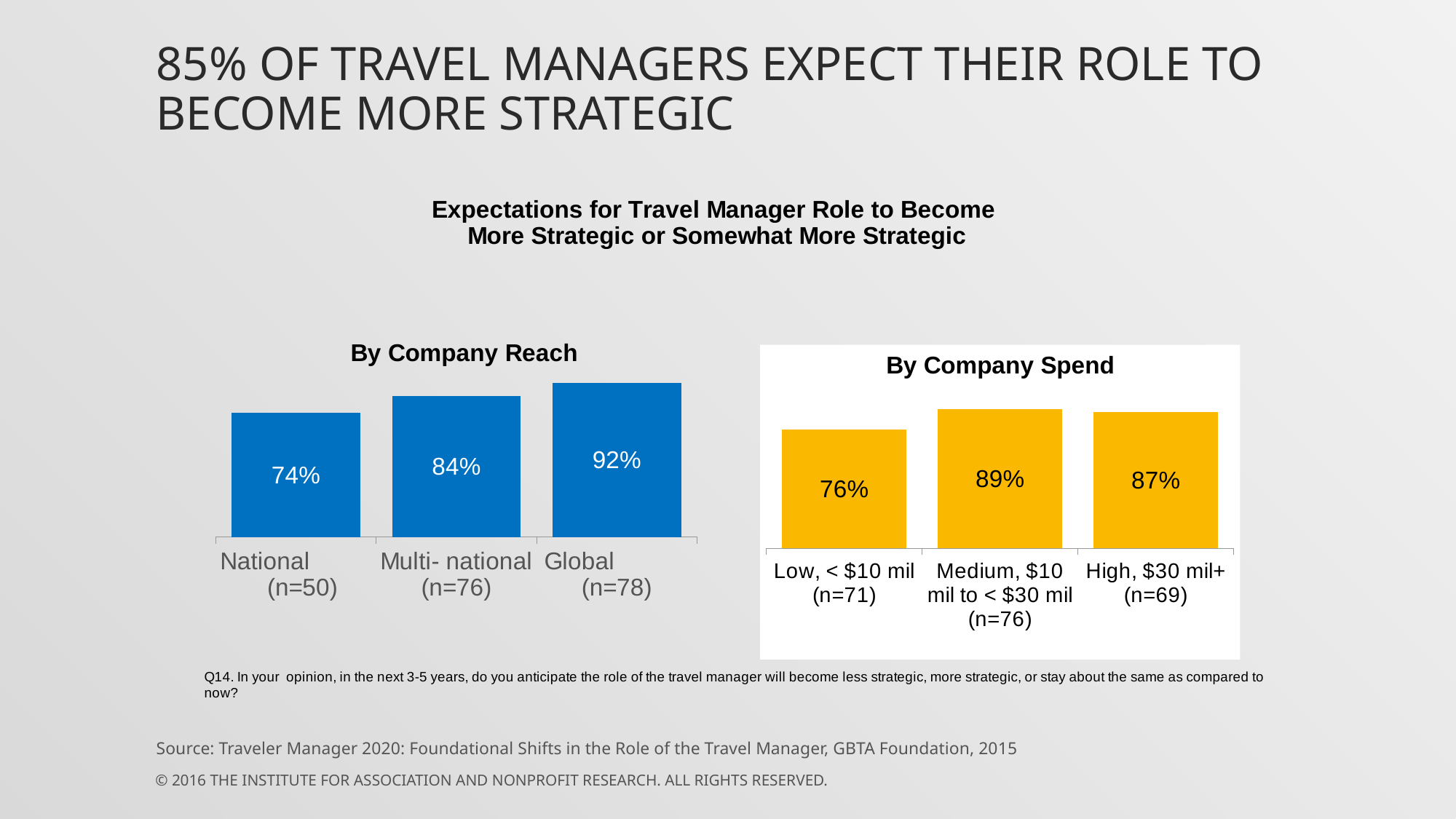
In the 'By Company Reach' chart, what is the value for Global? 92% In the 'By Company Reach' chart, which is larger, Multi-national or National? Multi-national In the 'By Company Spend' chart, which category has the lowest value? Low, < $10 mil In the 'By Company Spend' chart, what is the value for Low, < $10 mil? 76% In the 'By Company Reach' chart, which category has the highest value? Global In the 'By Company Reach' chart, do the values rise or fall from National to Global? Rise How many categories are shown in the 'By Company Spend' chart? 3 In the 'By Company Reach' chart, what is the difference between the Global and National values? 18% In the 'By Company Reach' chart, what is the value for National? 74% In the 'By Company Spend' chart, what is the value for Medium, $10 mil to < $30 mil? 89% What kind of chart is the 'By Company Reach' chart? Bar chart In the 'By Company Spend' chart, what is the difference between the Medium and High values? 2%